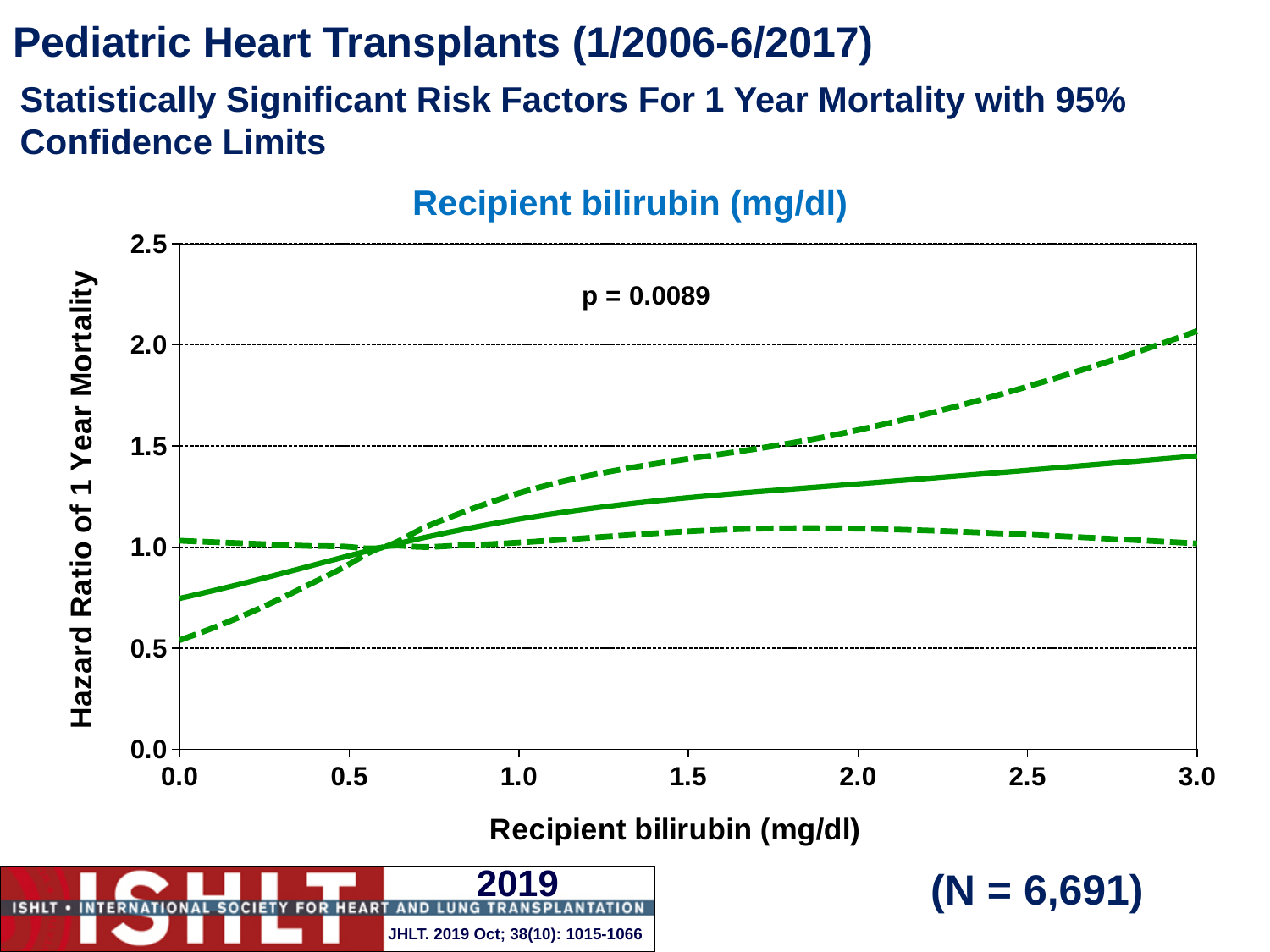
How many lines are plotted on the chart? 3 What is the label of the y axis? Hazard Ratio of 1 Year Mortality What is the highest value shown on the y axis of the chart? 2.5 Is the value of the upper dashed confidence limit at a recipient bilirubin of 1.0 mg/dl greater or less than 1.5? less Does the solid hazard ratio line rise or fall as recipient bilirubin increases from 0.0 to 3.0 mg/dl? rise Is the value of the solid hazard ratio line at a recipient bilirubin of 0.0 mg/dl greater or less than 1.0? less Is the value of the solid hazard ratio line at a recipient bilirubin of 3.0 mg/dl greater or less than 1.5? less What kind of chart is shown on the slide? line chart What p-value is printed on the chart? p = 0.0089 What is the title of the chart? Recipient bilirubin (mg/dl)